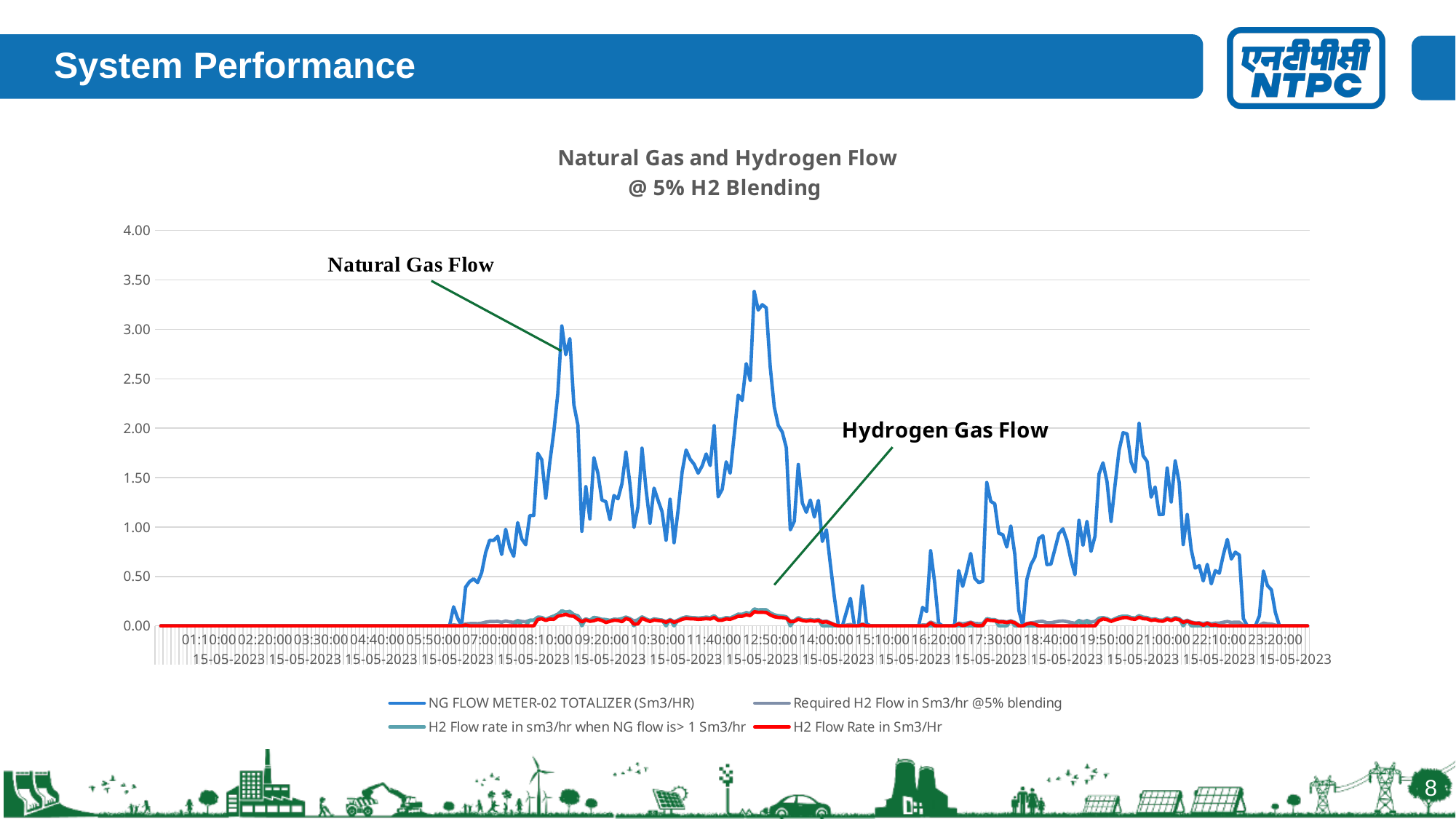
What type of chart is shown on the slide? Line chart Is the peak value of the NG FLOW METER-02 TOTALIZER (Sm3/HR) series near 12:50:00 greater or less than 3.00? greater Is the value of the NG FLOW METER-02 TOTALIZER (Sm3/HR) series at 01:10:00 greater or less than 0.50? less Between 12:50:00 and 14:00:00, does the NG FLOW METER-02 TOTALIZER (Sm3/HR) series rise or fall? Fall What is the highest value shown on the vertical axis of the chart? 4.00 Is the peak value of the NG FLOW METER-02 TOTALIZER (Sm3/HR) series near 21:00:00 greater or less than 2.50? less Between 05:50:00 and 08:10:00, does the NG FLOW METER-02 TOTALIZER (Sm3/HR) series rise or fall? Rise Which series reaches higher values, NG FLOW METER-02 TOTALIZER (Sm3/HR) or H2 Flow Rate in Sm3/Hr? NG FLOW METER-02 TOTALIZER (Sm3/HR) What is the title of the chart? Natural Gas and Hydrogen Flow @ 5% H2 Blending How many series does the chart legend list? 4